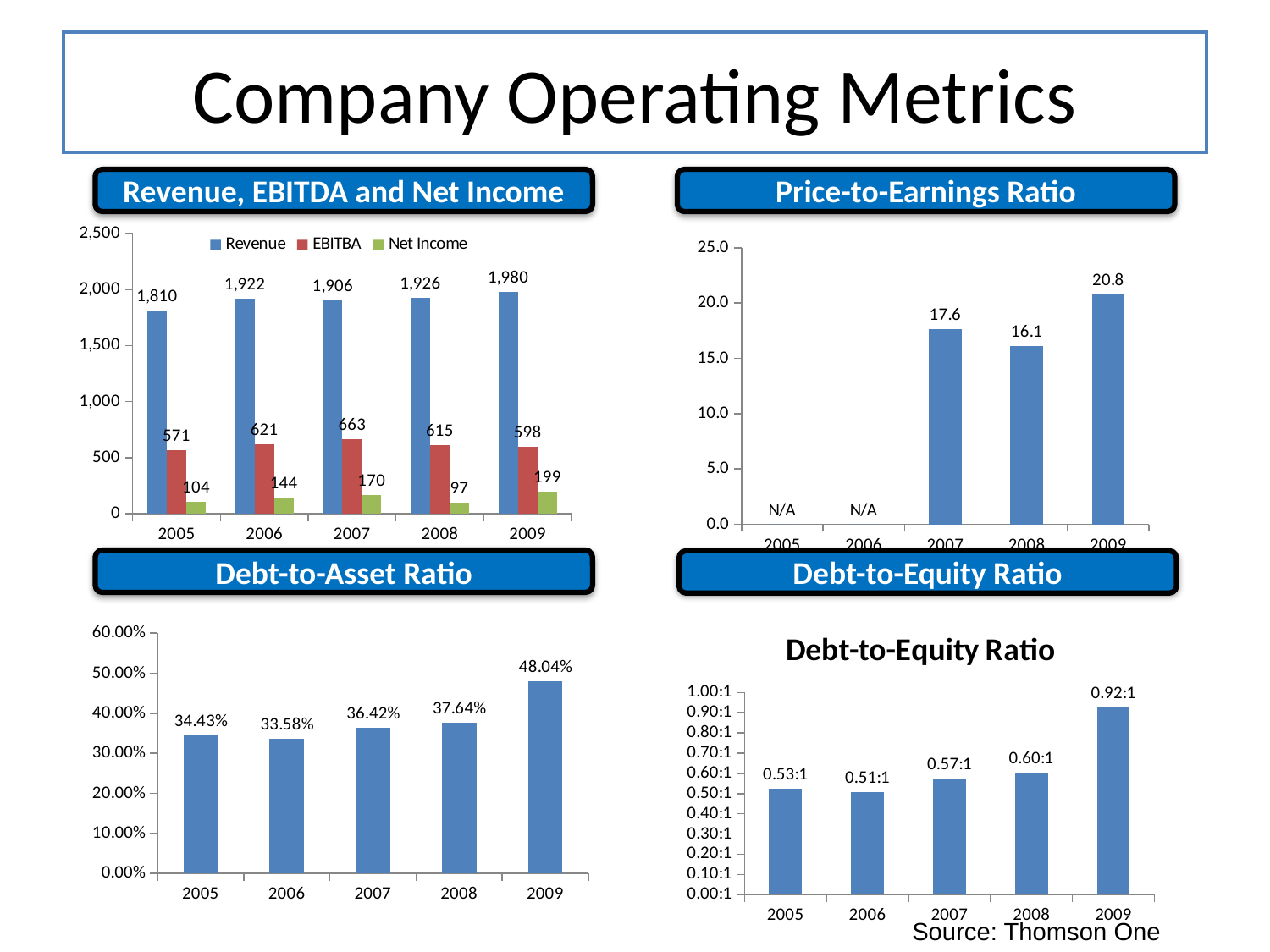
In the Revenue, EBITDA and Net Income chart, what is the Revenue value for 2009? 1,980 In the Debt-to-Equity Ratio chart, what is the value for 2009? 0.92:1 In the Revenue, EBITDA and Net Income chart, what is the difference between Revenue in 2009 and Revenue in 2005? 170 In the Price-to-Earnings Ratio chart, which year has the highest value? 2009 In the Debt-to-Asset Ratio chart, which year has the lowest value? 2006 What kind of chart is the Debt-to-Equity Ratio chart? Bar chart In the Revenue, EBITDA and Net Income chart, which year has the highest EBITDA value? 2007 In the Revenue, EBITDA and Net Income chart, which year has the lowest Net Income value? 2008 How many series does the legend of the Revenue, EBITDA and Net Income chart list? 3 In the Price-to-Earnings Ratio chart, what is shown for 2005 and 2006? N/A In the Price-to-Earnings Ratio chart, what is the value for 2007? 17.6 In the Debt-to-Asset Ratio chart, what is the value for 2008? 37.64%